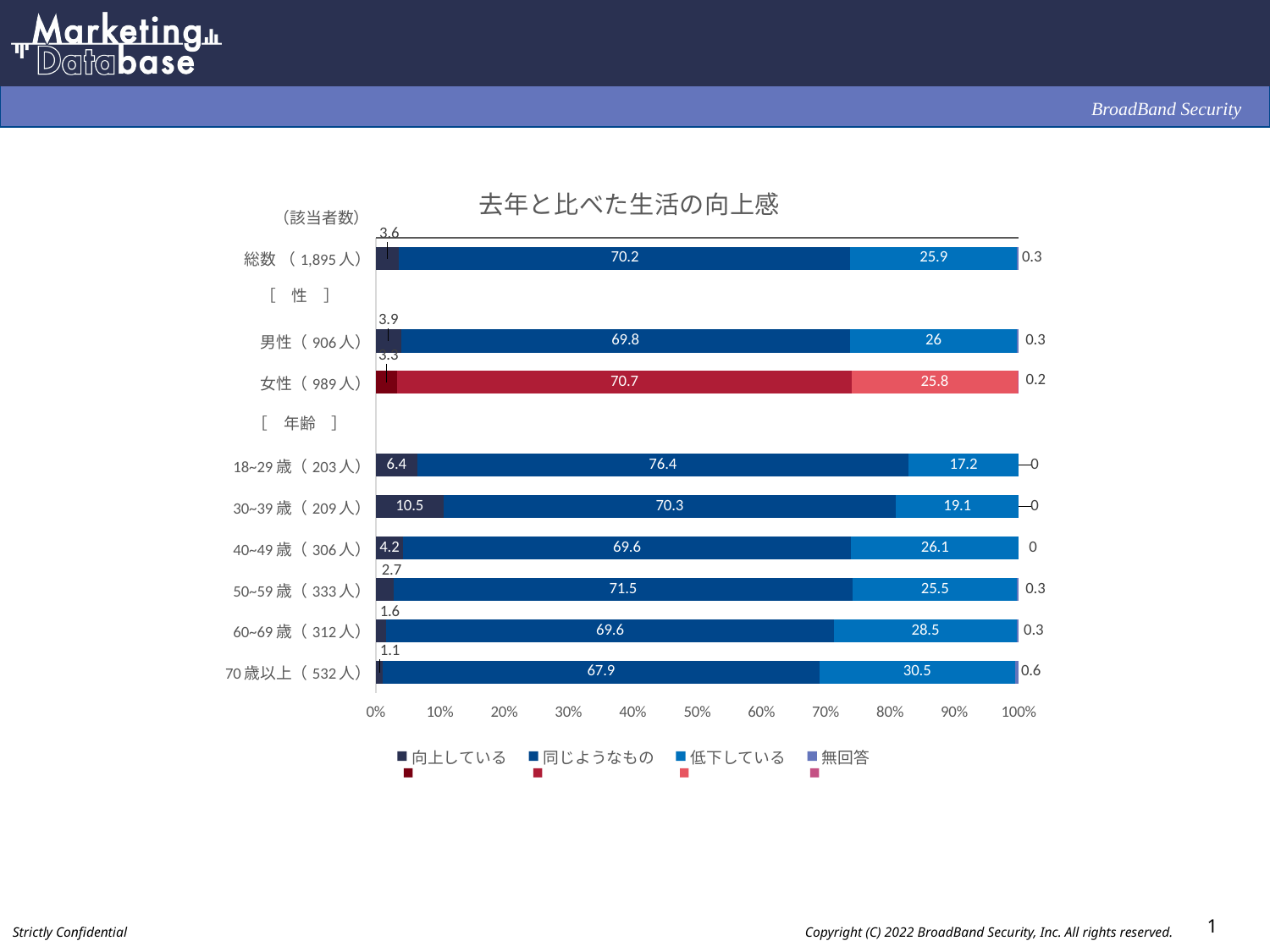
Which category has the lowest value for 低下している? 18~29歳 How many series does the legend list? 4 What is the value of 同じようなもの for 18~29歳? 76.4 What is the value of 向上している for 30~39歳? 10.5 What kind of chart is shown on the slide? Stacked bar chart Which is larger, the 同じようなもの value for 男性 or for 女性? 女性 Which category has the highest value for 向上している? 30~39歳 What is the title of the chart? 去年と比べた生活の向上感 What is the value of 低下している for 70歳以上? 30.5 How many age-group categories (年齢) are plotted in the chart? 6 What is the value of 無回答 for 女性? 0.2 What is the difference between the 低下している values for 70歳以上 and 18~29歳? 13.3